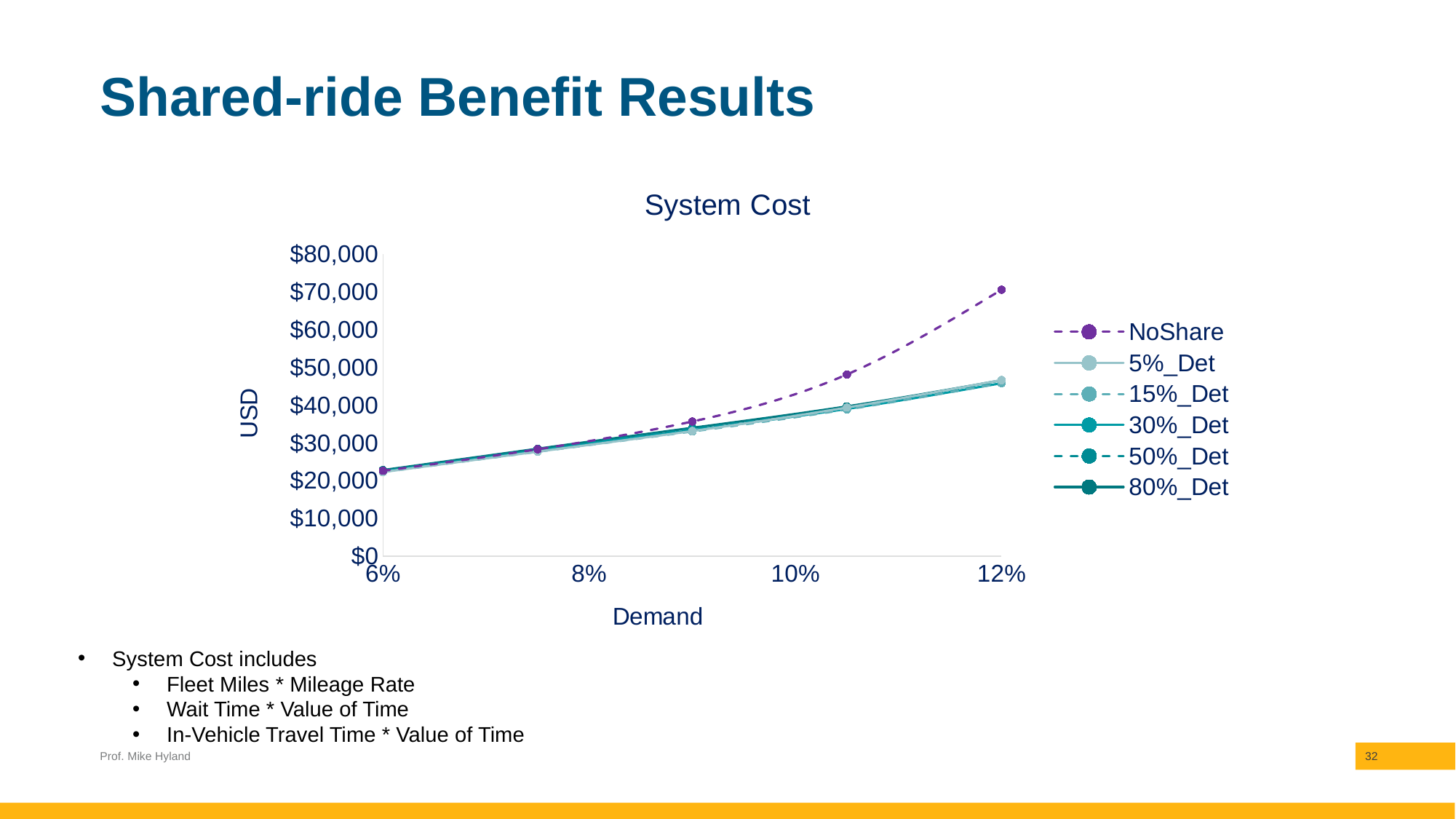
How many series does the legend of the System Cost chart list? 6 Does the 80%_Det series rise or fall as Demand increases? rise What kind of chart is shown on the slide? line chart What is the label of the x axis of the chart? Demand Does the NoShare series rise or fall as Demand increases from 6% to 12%? rise At 6% Demand, is the value for NoShare greater or less than $30,000? less How many data points are plotted for the NoShare series? 5 Which series has the highest System Cost at 12% Demand? NoShare What is the title of the chart? System Cost At 12% Demand, is the value for 5%_Det greater or less than $50,000? less At 12% Demand, which is larger: the value for NoShare or the value for 80%_Det? NoShare At 12% Demand, is the value for NoShare greater or less than $60,000? greater